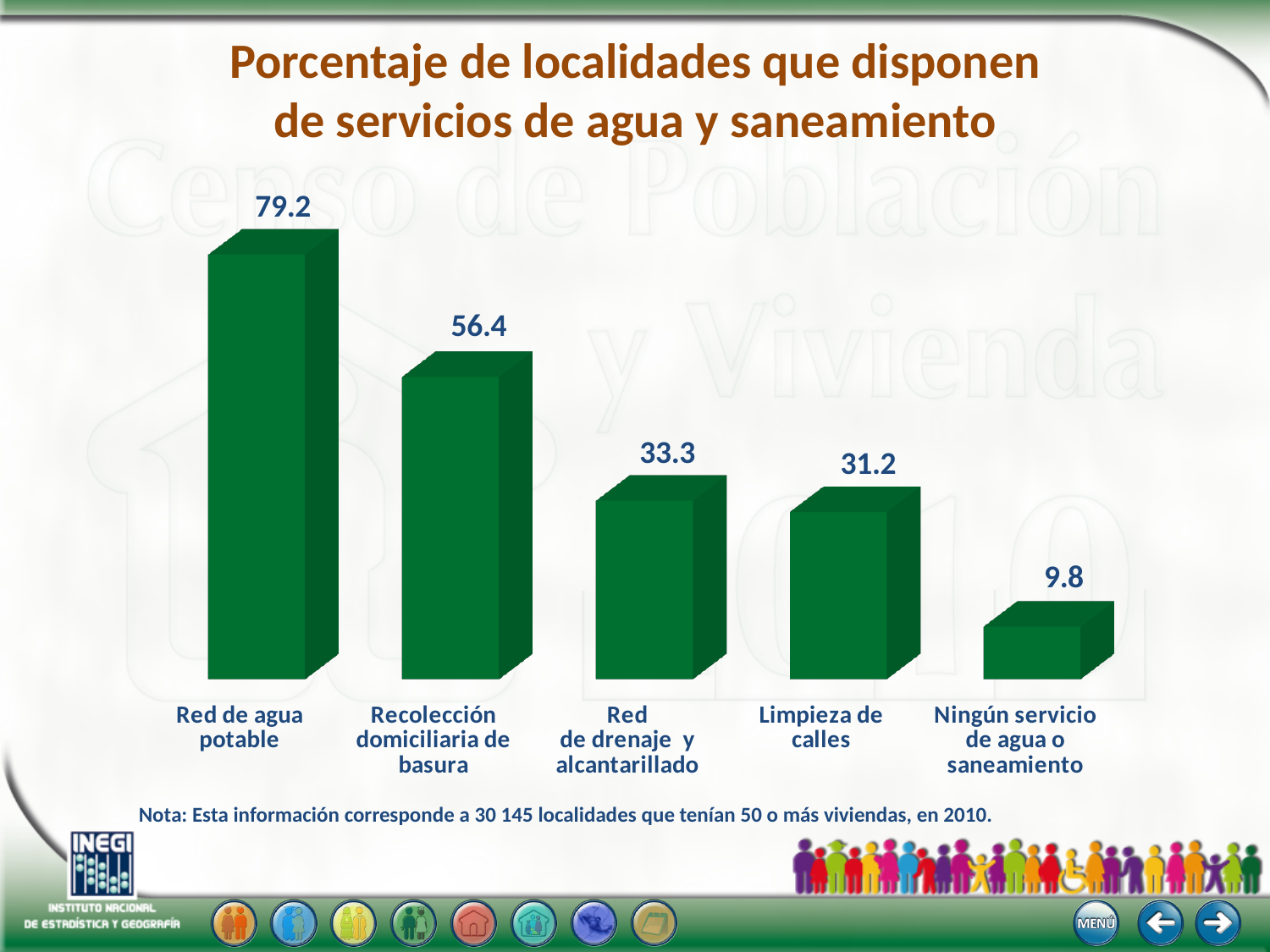
What is the value for Red de drenaje y alcantarillado? 33.3 Which category has the lowest value? Ningún servicio de agua o saneamiento What is the difference between the values for Red de agua potable and Recolección domiciliaria de basura? 22.8 How many categories are shown in the chart? 5 What is the value for Recolección domiciliaria de basura? 56.4 What is the value for Limpieza de calles? 31.2 What is the difference between the values for Red de drenaje y alcantarillado and Limpieza de calles? 2.1 What is the value for Ningún servicio de agua o saneamiento? 9.8 What kind of chart is shown on the slide? Bar chart Which category has the highest value? Red de agua potable What is the value for Red de agua potable? 79.2 Which is larger, the value for Recolección domiciliaria de basura or the value for Red de drenaje y alcantarillado? Recolección domiciliaria de basura